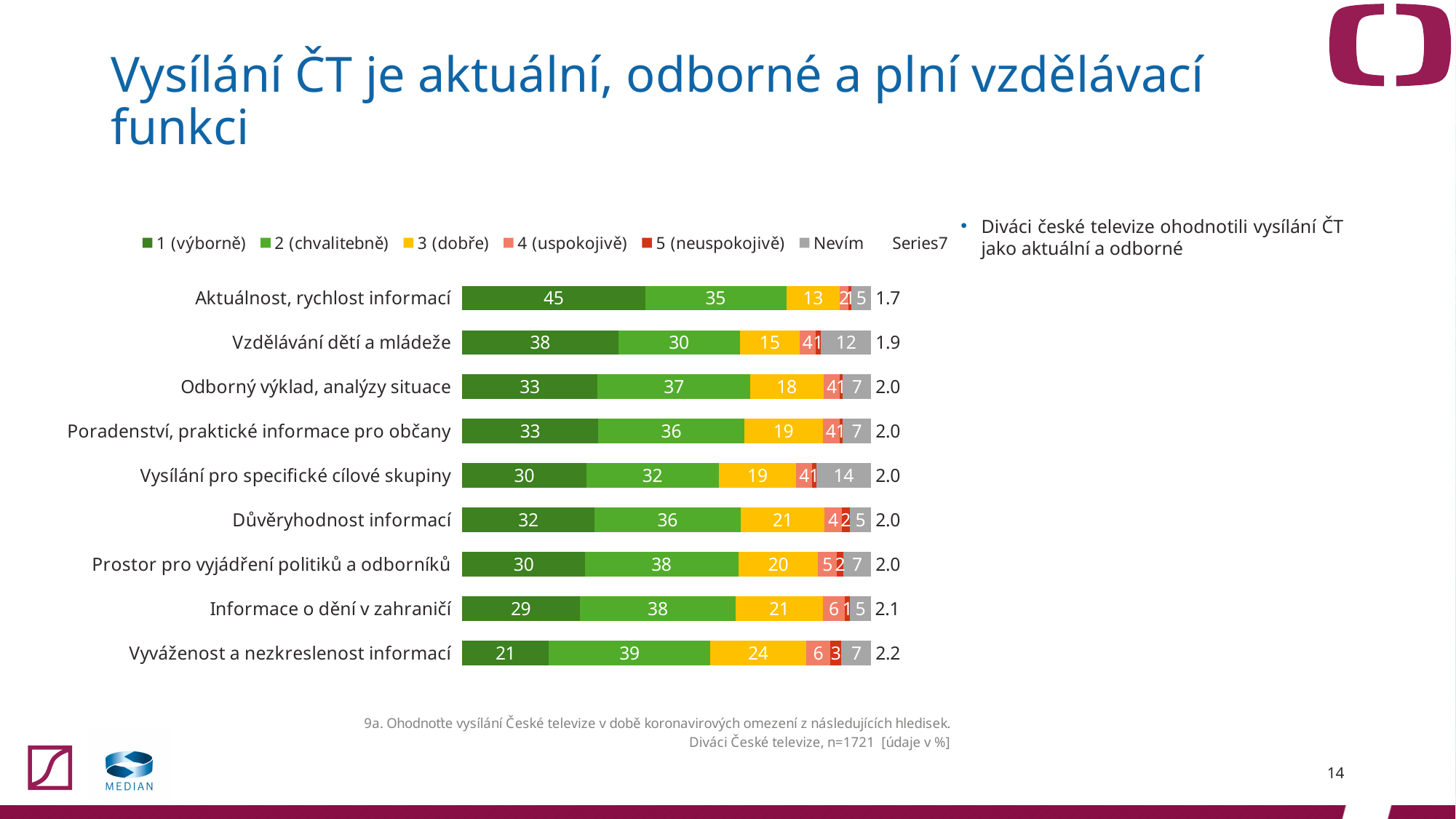
What kind of chart is shown on the slide? Stacked bar chart What is the difference between the 2 (chvalitebně) values for Vyváženost a nezkreslenost informací and Aktuálnost, rychlost informací? 4 What is the value for 1 (výborně) in the Aktuálnost, rychlost informací bar? 45 Which category has the lowest 1 (výborně) value? Vyváženost a nezkreslenost informací What colour represents 1 (výborně) in the chart? Dark green Which has the larger 3 (dobře) value: Vyváženost a nezkreslenost informací or Důvěryhodnost informací? Vyváženost a nezkreslenost informací What number is printed at the end of the Vyváženost a nezkreslenost informací bar? 2.2 What is the Nevím value for Vzdělávání dětí a mládeže? 12 How many series does the legend list? 7 How many categories are shown in the chart? 9 Which category has the highest 1 (výborně) value? Aktuálnost, rychlost informací What is the 3 (dobře) value for Odborný výklad, analýzy situace? 18